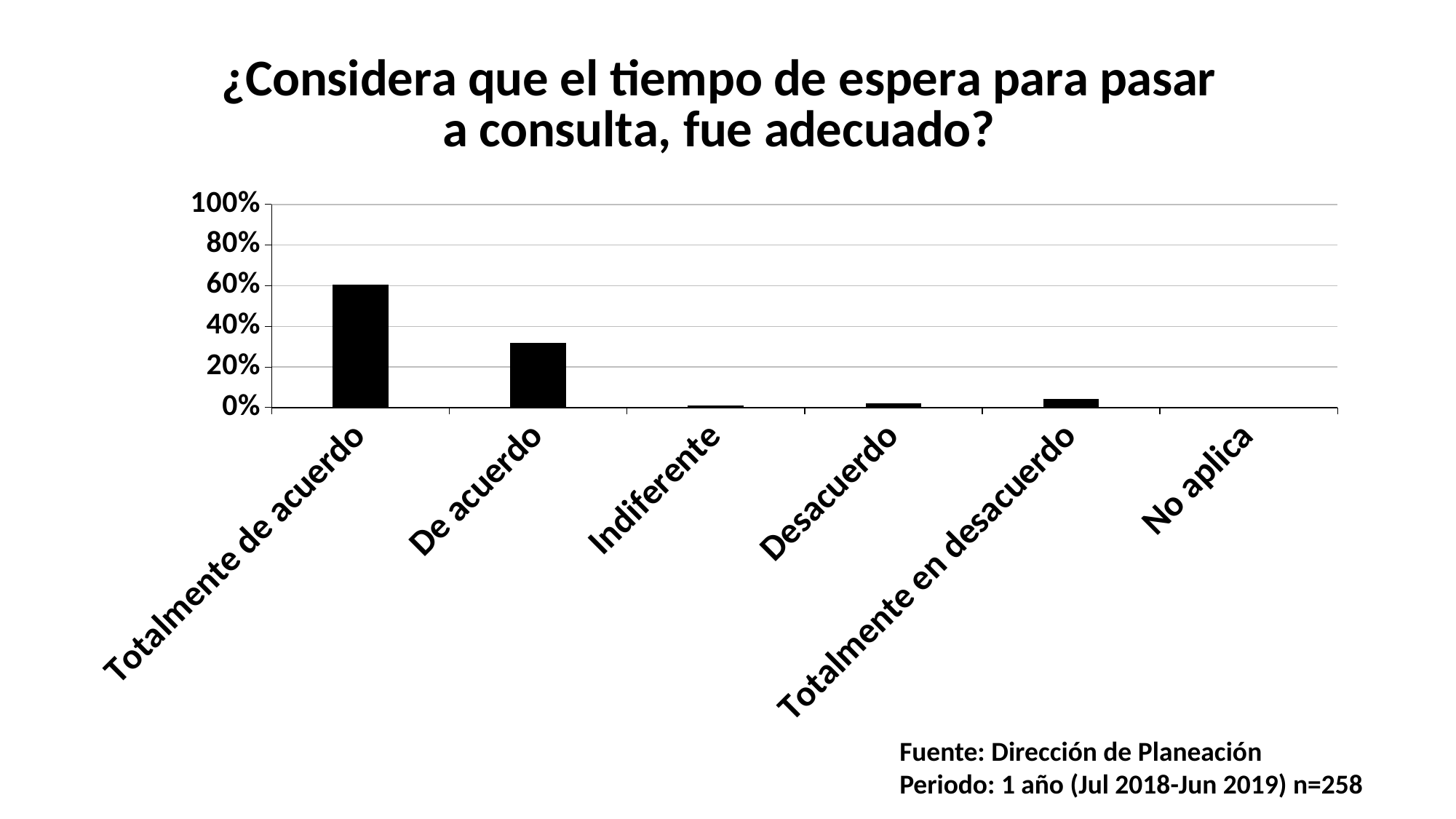
Is the value for De acuerdo greater or less than 20%? greater What kind of chart is shown on the slide? Bar chart What is the title of the chart? ¿Considera que el tiempo de espera para pasar a consulta, fue adecuado? Which category has the highest value in the chart? Totalmente de acuerdo Is the value for Totalmente de acuerdo greater or less than 40%? greater Which is larger, the value for Totalmente de acuerdo or the value for De acuerdo? Totalmente de acuerdo Is the value for De acuerdo greater or less than 40%? less How many categories are shown on the x axis of the chart? 6 What sample size (n) is stated on the slide? n=258 Which is larger, the value for Totalmente en desacuerdo or the value for Desacuerdo? Totalmente en desacuerdo